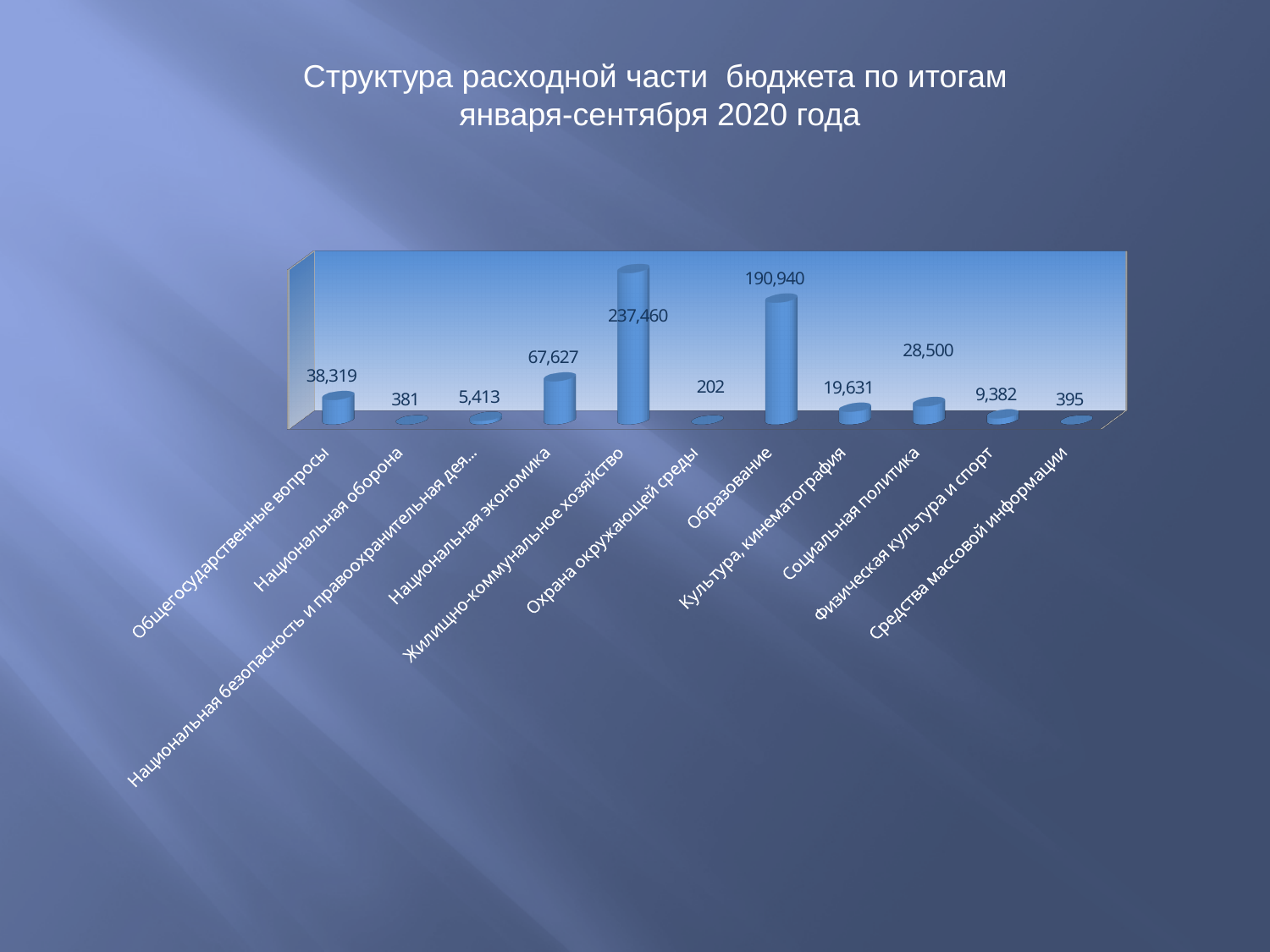
What is the value for Национальная экономика? 67,627 What is the title of the slide? Структура расходной части бюджета по итогам января-сентября 2020 года What is the value for Социальная политика? 28,500 How many categories are shown in the chart? 11 What is the value for Образование? 190,940 Which category has the lowest value? Охрана окружающей среды Which is larger, the value for Культура, кинематография or the value for Физическая культура и спорт? Культура, кинематография What is the value for Средства массовой информации? 395 Which category has the highest value? Жилищно-коммунальное хозяйство What kind of chart is shown on the slide? Bar chart What is the difference between the values for Жилищно-коммунальное хозяйство and Образование? 46,520 What is the difference between the values for Общегосударственные вопросы and Социальная политика? 9,819